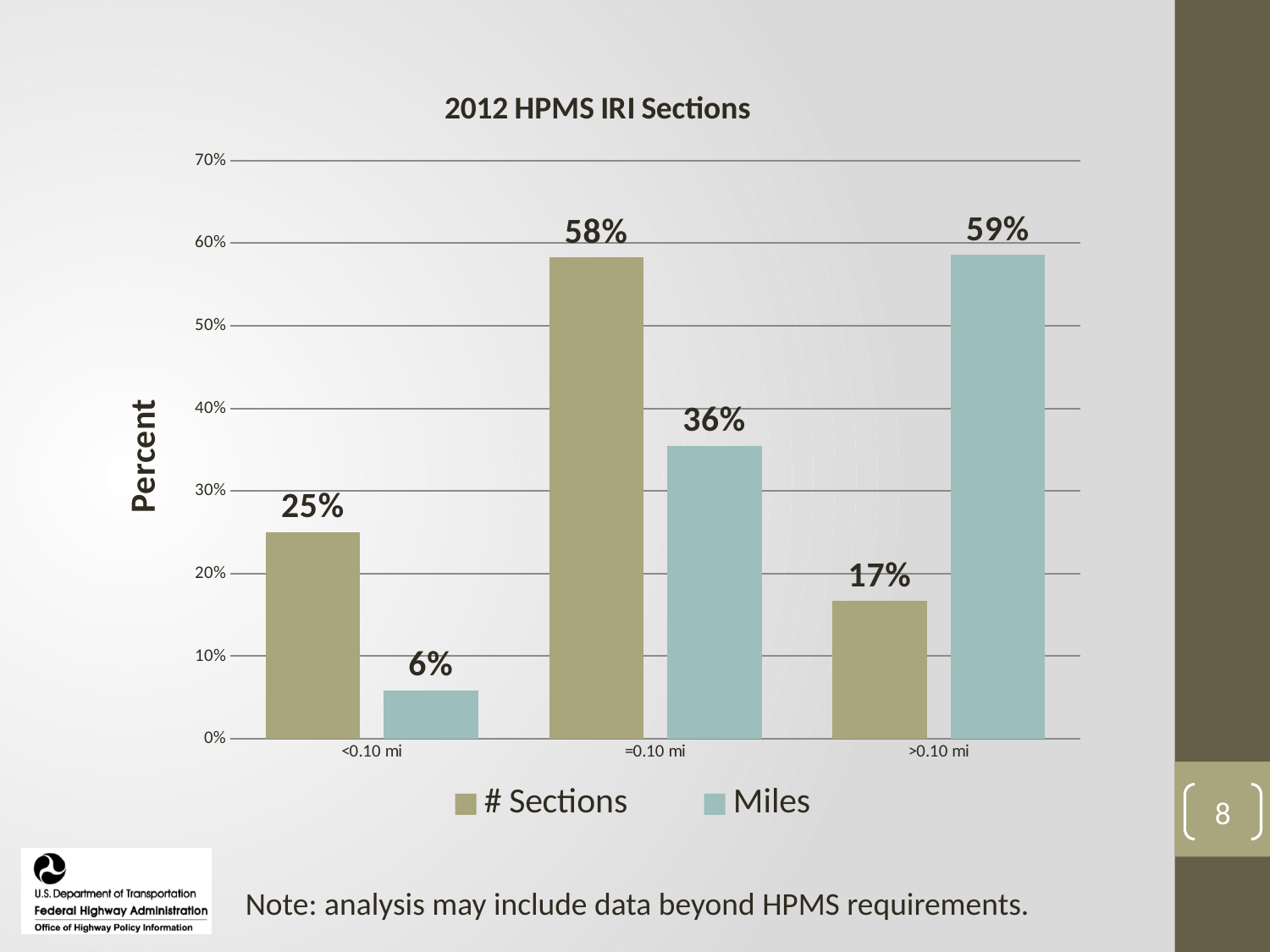
Which category has the lowest value for Miles? <0.10 mi What is the value for Miles in the >0.10 mi category? 59% What is the value for # Sections in the <0.10 mi category? 25% Is the value for # Sections in the =0.10 mi category greater or less than 50%? greater What kind of chart is shown on the slide? bar chart How many series does the legend list? 2 What is the title of the chart? 2012 HPMS IRI Sections What is the value for Miles in the =0.10 mi category? 36% What is the difference between # Sections and Miles in the <0.10 mi category? 19% Which category has the highest value for # Sections? =0.10 mi Which is larger in the >0.10 mi category, # Sections or Miles? Miles How many categories are shown on the x axis? 3